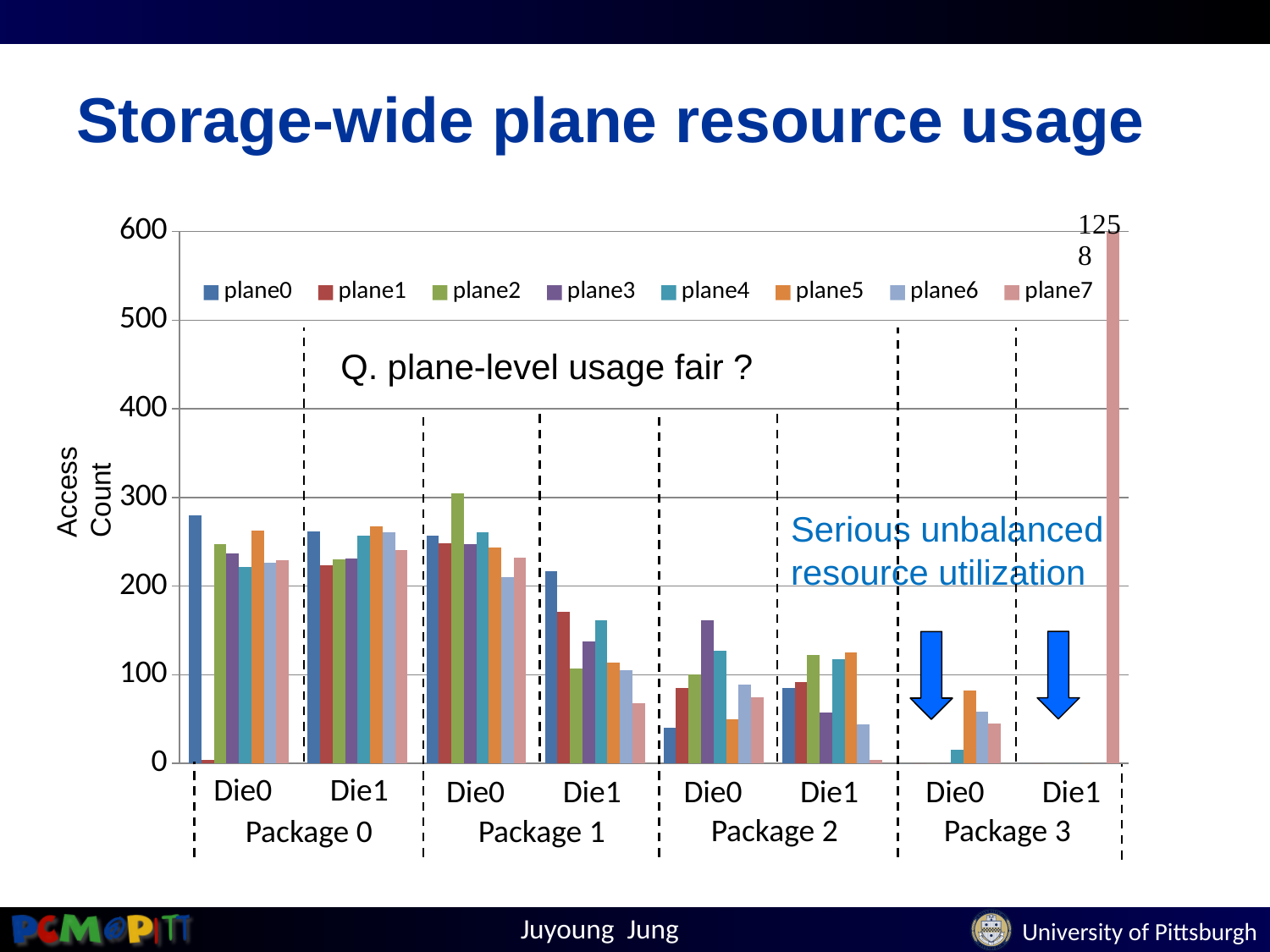
Is the value for plane2 in Die0 of Package 1 greater or less than 250? greater How many series does the legend list? 8 Is the value for plane0 in Die0 of Package 2 greater or less than 100? less How many die categories are shown along the x axis? 8 What is the title of the slide's chart? Storage-wide plane resource usage Is the value for plane0 in Die0 of Package 0 greater or less than 200? greater In Die0 of Package 2, which is larger, the value for plane3 or the value for plane1? plane3 What kind of chart is shown on the slide? bar chart Which plane has the highest access count for Die1 of Package 3? plane7 In Die1 of Package 1, which is larger, the value for plane0 or the value for plane2? plane0 What is the label on the y axis? Access Count